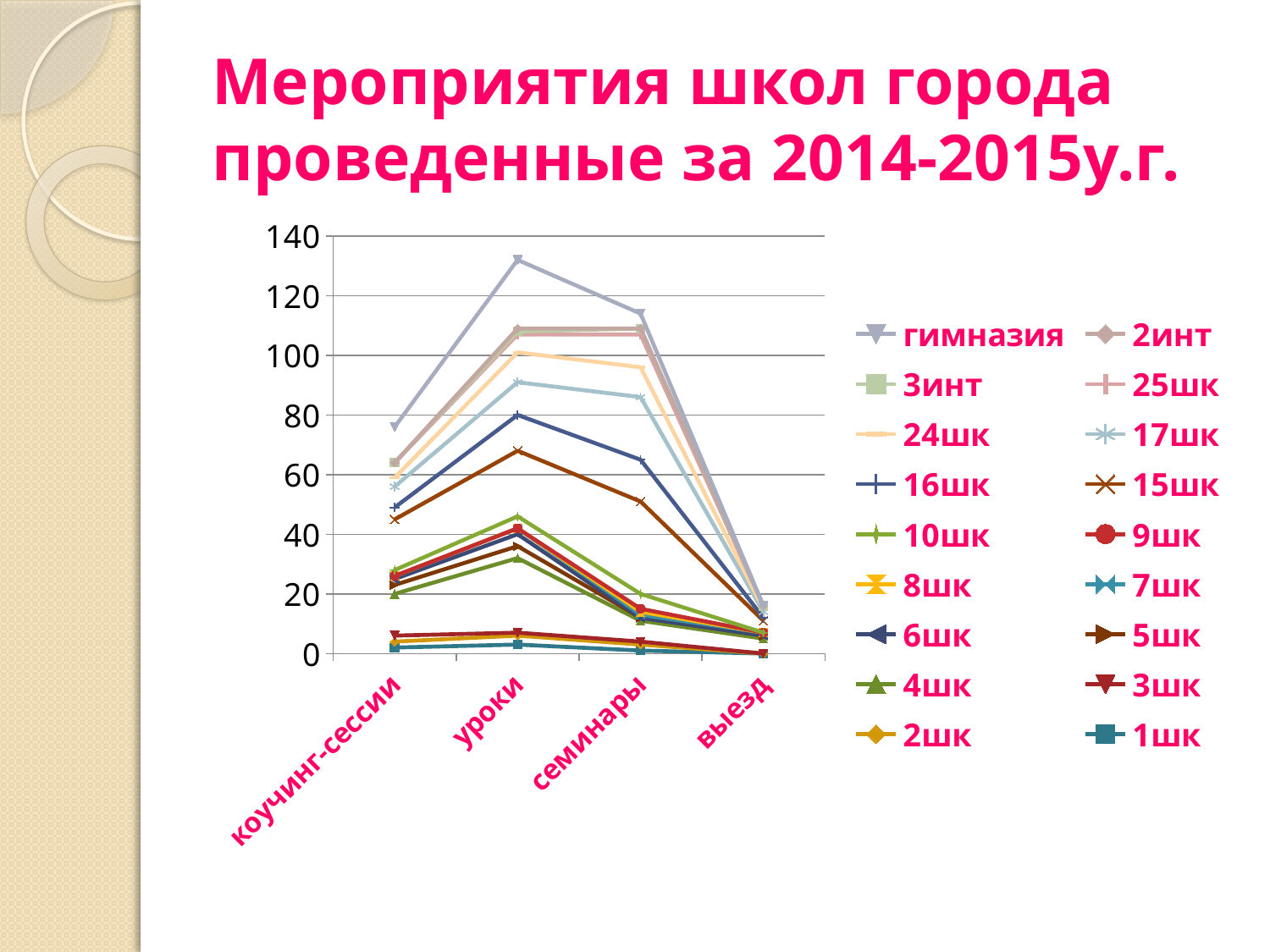
What is the highest value shown on the chart's vertical axis? 140 How many series does the chart's legend list? 18 At which category does the гимназия series reach its highest value? уроки How many categories are shown on the x axis of the chart? 4 Which is larger at уроки: the value for гимназия or the value for 15шк? гимназия What kind of chart is shown on the slide? line chart Does the гимназия line rise or fall from уроки to выезд? fall